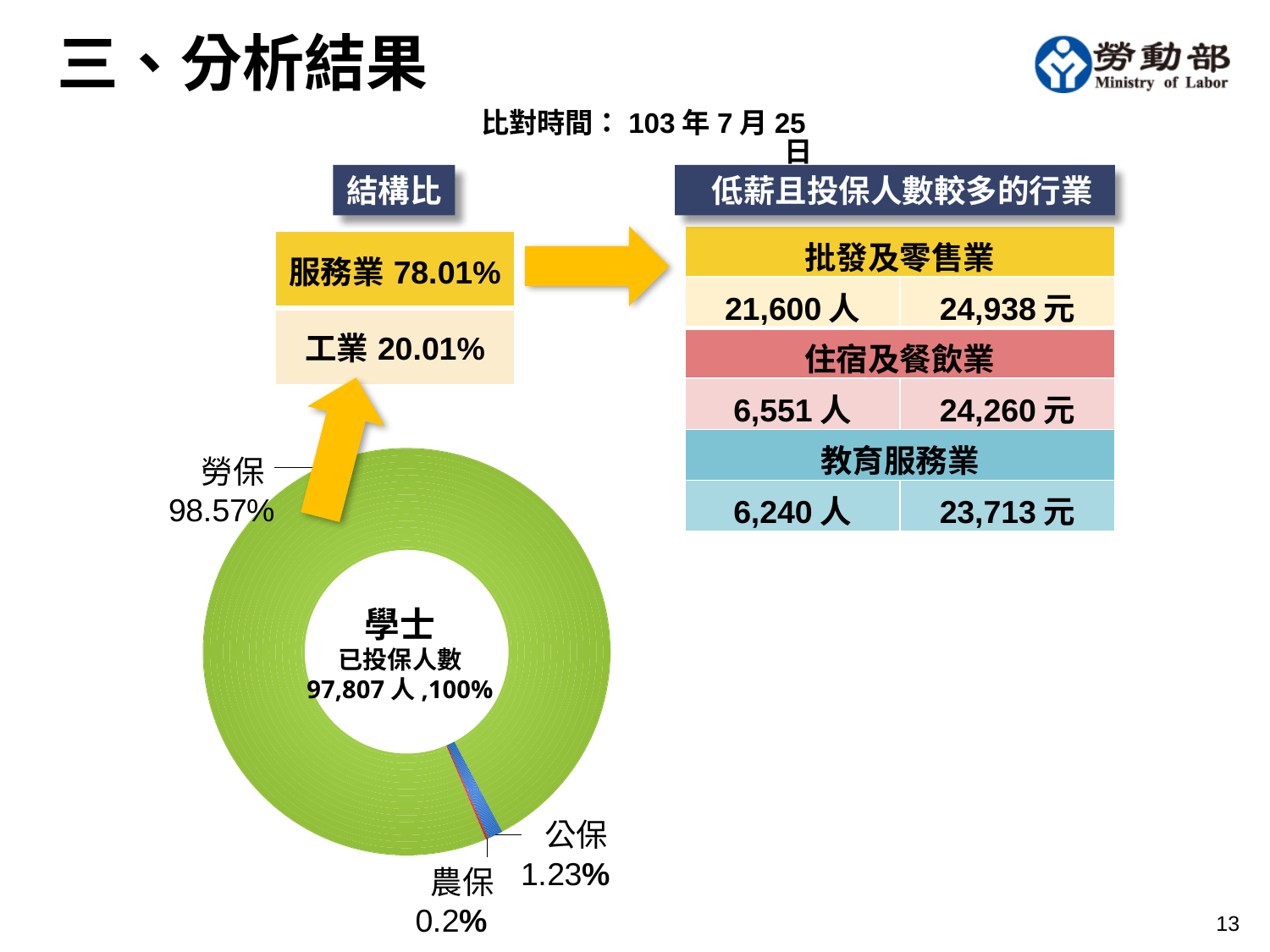
Which group (degree level) does the donut chart describe, according to its centre label? 學士 Which category has the smallest share of the donut chart? 農保 What is the difference in percentage points between 公保 and 農保 in the donut chart? 1.03% How many categories are shown in the donut chart? 3 Which category has the largest share of the donut chart? 勞保 What percentage is shown for 農保 in the donut chart? 0.2% What total number of insured persons is printed in the centre of the donut chart? 97,807 人 What share of the donut chart does 勞保 account for? 98.57% What percentage is shown for 公保 in the donut chart? 1.23% What is the difference in percentage points between 勞保 and 公保 in the donut chart? 97.34% What kind of chart is used to show the 勞保, 公保 and 農保 shares? Pie chart (donut) Which is larger in the donut chart, 公保 or 農保? 公保